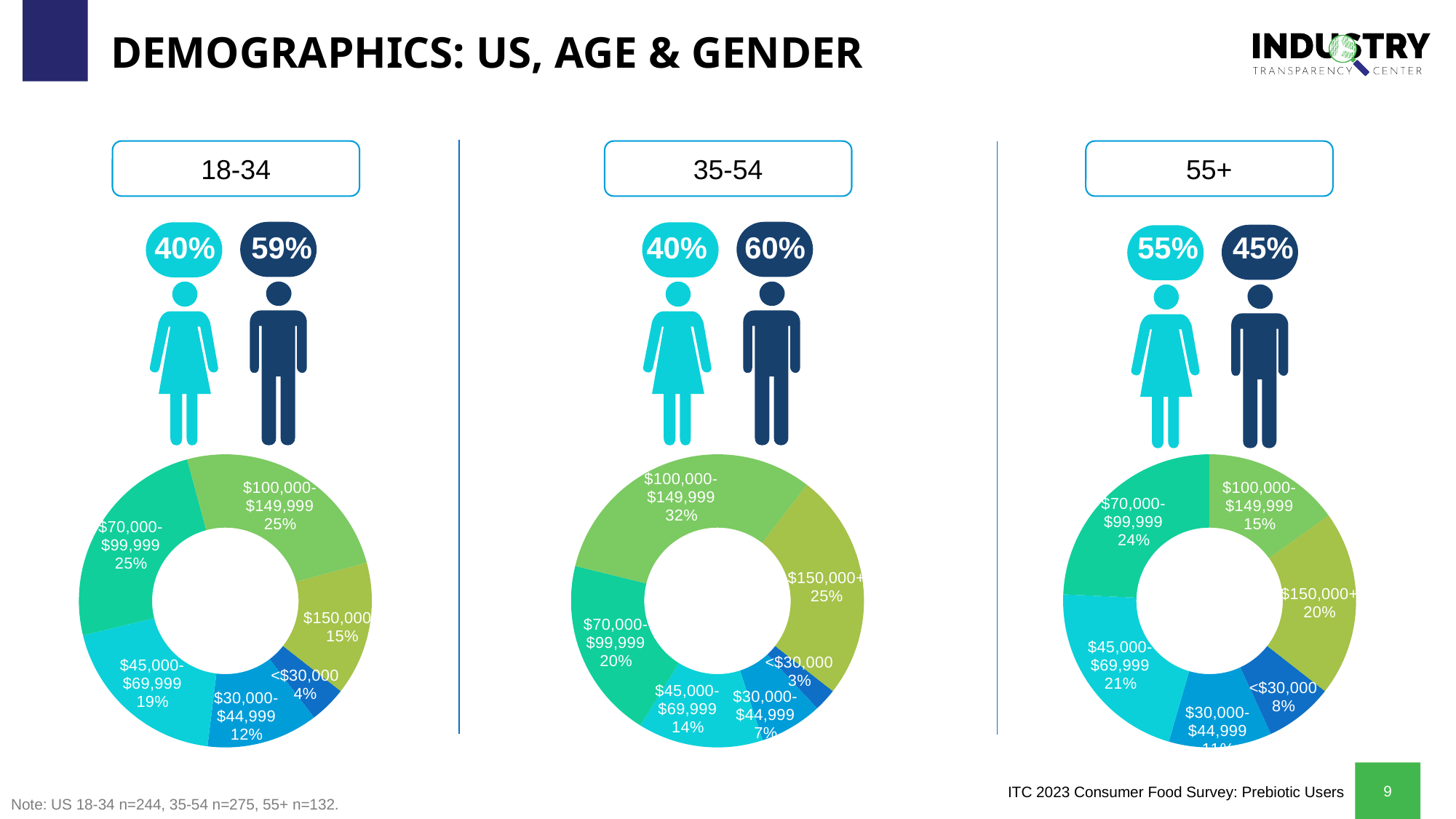
How many income brackets are shown in the 18-34 donut chart? 6 In the 35-54 donut chart, which income bracket has the largest share? $100,000-$149,999 In the 18-34 donut chart, what share of respondents have an income of $100,000-$149,999? 25% What type of chart is used to show income distribution for each age group? Donut chart In the 55+ donut chart, which income bracket has the largest share? $70,000-$99,999 In the 35-54 donut chart, what is the difference between the $100,000-$149,999 share and the $70,000-$99,999 share? 12 percentage points In the 35-54 donut chart, what share of respondents have an income of $150,000+? 25% In the 55+ donut chart, what share of respondents have an income of <$30,000? 8% In the 18-34 donut chart, which income bracket has the smallest share? <$30,000 In the 55+ donut chart, which is larger: the share for $150,000+ or the share for $100,000-$149,999? $150,000+ How many donut charts are on the slide? 3 In the 18-34 donut chart, which is larger: the share for $45,000-$69,999 or the share for $150,000+? $45,000-$69,999